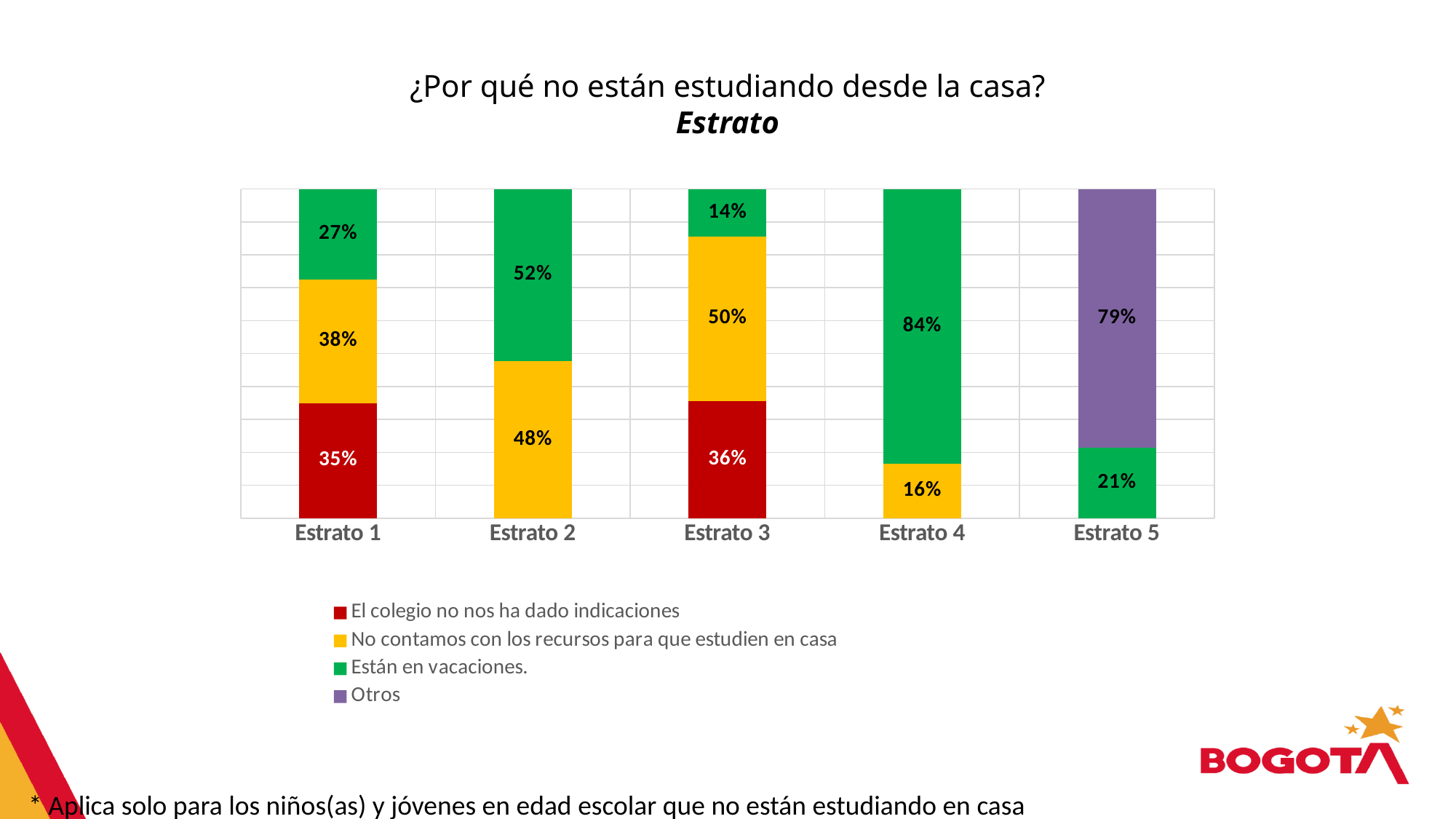
What is the value for "El colegio no nos ha dado indicaciones" in Estrato 3? 36% How many series does the legend list? 4 Which estrato has the highest value for "Están en vacaciones."? Estrato 4 Which is larger: the "No contamos con los recursos para que estudien en casa" value in Estrato 3 or in Estrato 1? Estrato 3 What is the difference between the "Están en vacaciones." values for Estrato 2 and Estrato 1? 25% What is the value for "Otros" in Estrato 5? 79% What is the value for "Están en vacaciones." in Estrato 4? 84% Which series is shown in purple in the legend? Otros How many estratos (categories) are shown on the x axis? 5 Which estrato has the lowest value for "Están en vacaciones."? Estrato 3 What is the value for "No contamos con los recursos para que estudien en casa" in Estrato 2? 48% What kind of chart is shown on the slide? Stacked bar chart